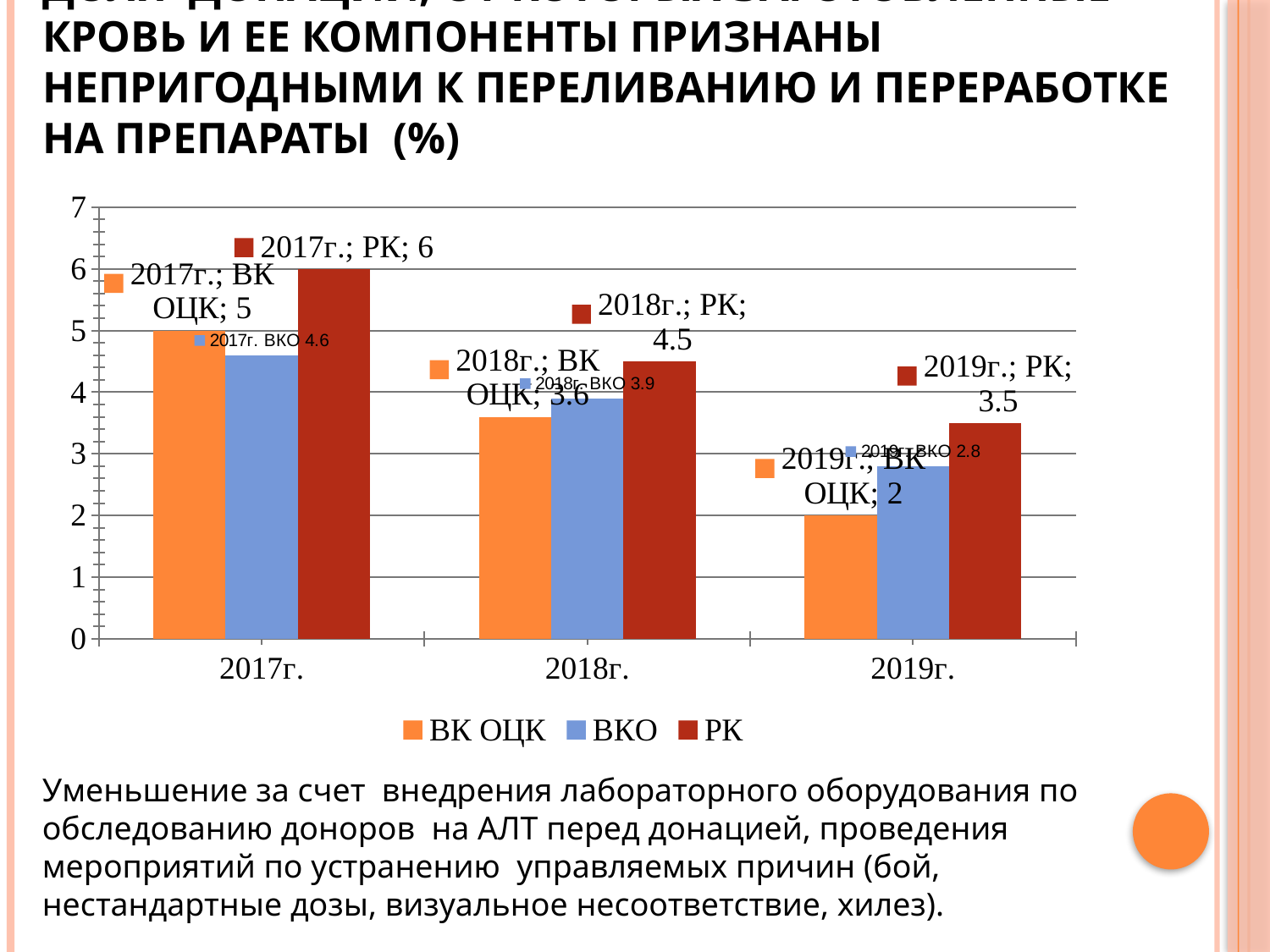
What type of chart is shown on the slide? bar chart What is the difference between the РК value in 2017г. and the РК value in 2019г.? 2.5 Which series is shown in dark red in the legend? РК Which is larger in 2018г., ВК ОЦК or ВКО? ВКО Which year has the highest value for РК? 2017г. What is the value for ВКО in 2018г.? 3.9 What is the value for ВК ОЦК in 2019г.? 2 How many year categories are shown on the x axis? 3 Which year has the lowest value for ВК ОЦК? 2019г. How many series does the legend list? 3 What is the value for РК in 2017г.? 6 Do the РК values rise or fall from 2017г. to 2019г.? fall